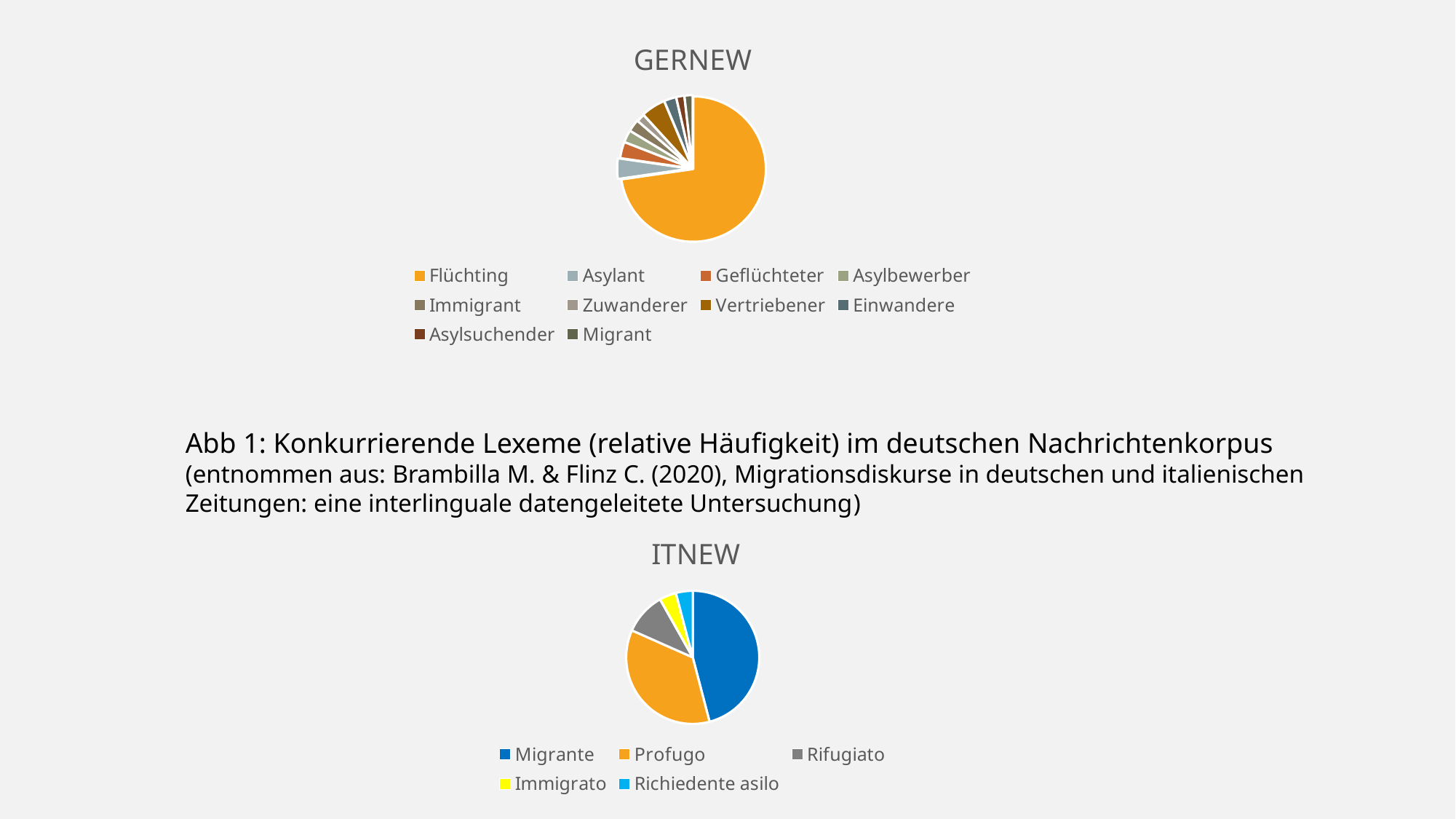
In the ITNEW pie chart, what colour is the Migrante slice? blue In the GERNEW pie chart, which slice is larger, Flüchting or Asylant? Flüchting How many categories does the GERNEW pie chart's legend list? 10 What is the title of the upper pie chart on the slide? GERNEW What kind of chart is the ITNEW chart? pie chart In the ITNEW pie chart, which slice is larger, Profugo or Rifugiato? Profugo What kind of chart is the GERNEW chart? pie chart In the ITNEW pie chart, which slice is larger, Rifugiato or Immigrato? Rifugiato How many categories does the ITNEW pie chart's legend list? 5 In the GERNEW pie chart, which category has the largest slice? Flüchting